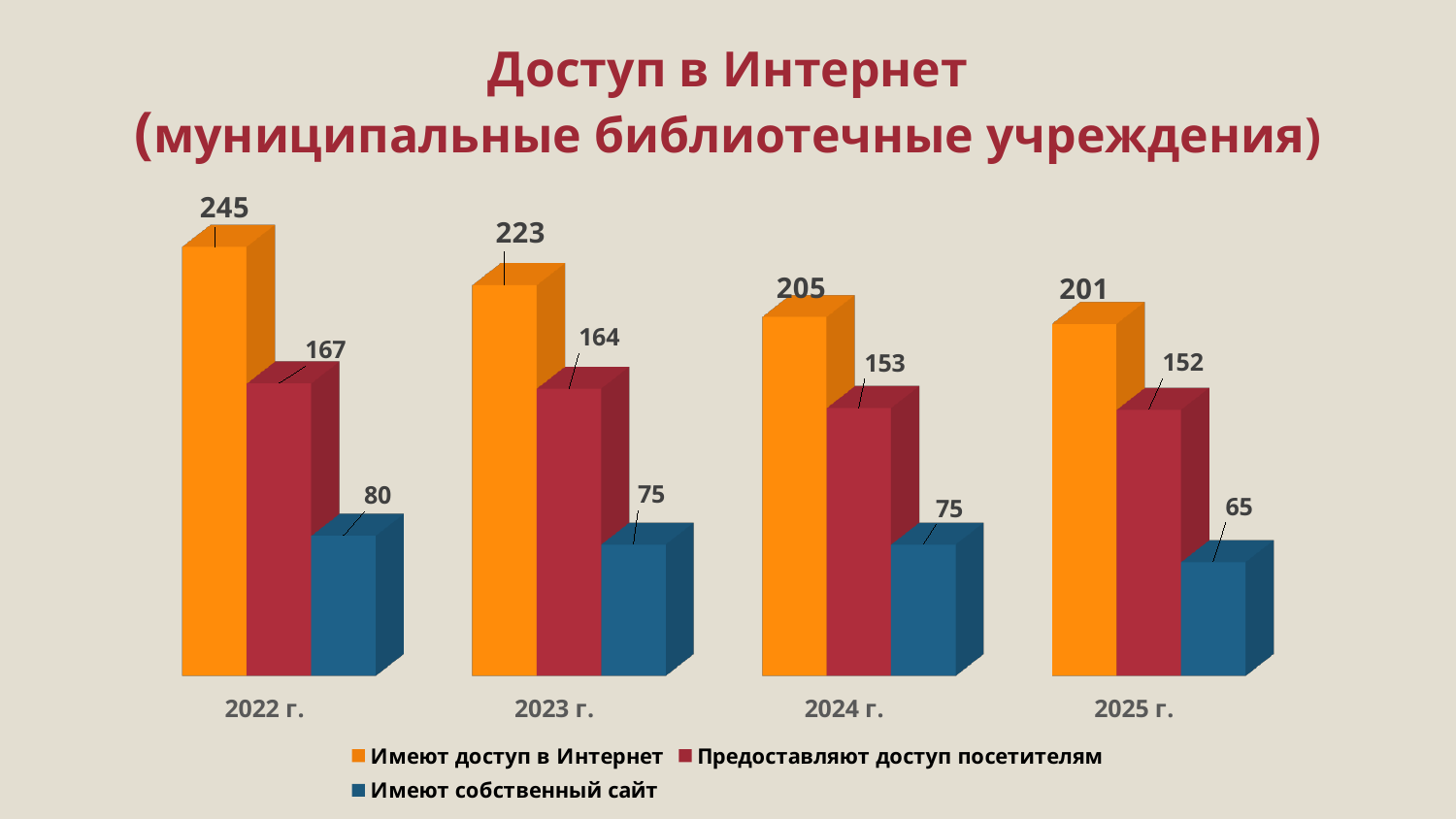
In which year is the value for "Имеют собственный сайт" the lowest? 2025 г. Which colour represents "Предоставляют доступ посетителям" in the legend? Red In which year is the value for "Имеют доступ в Интернет" the highest? 2022 г. Does the value for "Имеют доступ в Интернет" rise or fall from 2022 г. to 2025 г.? Fall How many series does the legend list? 3 Which is larger: "Имеют собственный сайт" in 2022 г. or in 2024 г.? 2022 г. What is the value for "Имеют собственный сайт" in 2025 г.? 65 What kind of chart is shown on the slide? Bar chart What is the value for "Предоставляют доступ посетителям" in 2024 г.? 153 What is the value for "Имеют доступ в Интернет" in 2022 г.? 245 What is the difference between "Имеют доступ в Интернет" and "Предоставляют доступ посетителям" in 2023 г.? 59 How many years are shown on the x axis? 4